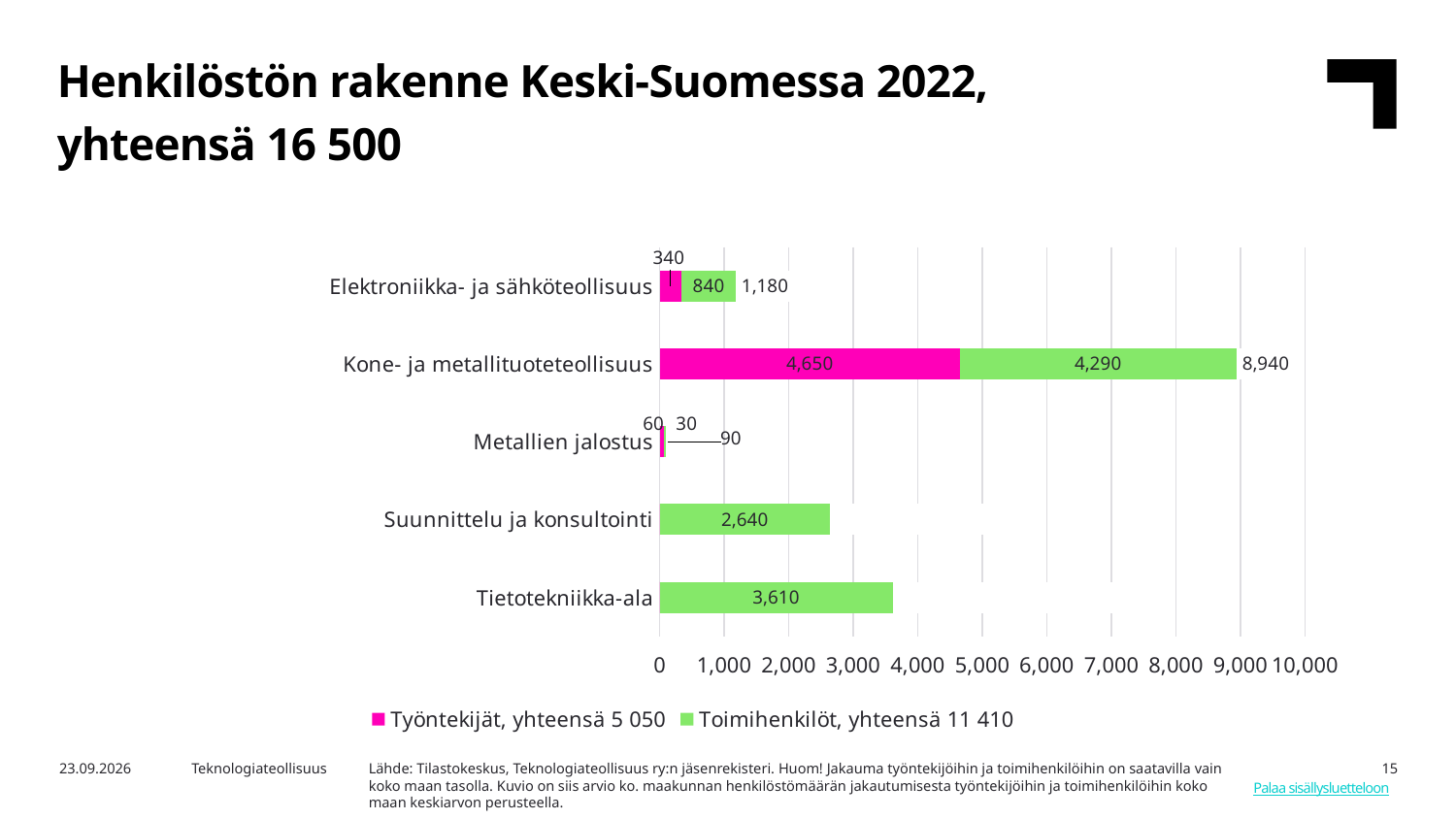
Which category has the lowest total value? Metallien jalostus What is the difference between the Toimihenkilöt values for Tietotekniikka-ala and Suunnittelu ja konsultointi? 970 What is the Työntekijät value for Kone- ja metallituoteteollisuus? 4,650 What is the total of the stacked bar for Kone- ja metallituoteteollisuus? 8,940 Which category has the highest total value? Kone- ja metallituoteteollisuus How many series does the legend list? 2 How many categories are shown on the chart? 5 What is the Toimihenkilöt value for Elektroniikka- ja sähköteollisuus? 840 What type of chart is shown on the slide? Stacked bar chart Which is larger for Kone- ja metallituoteteollisuus, the Työntekijät value or the Toimihenkilöt value? Työntekijät What is the total of the stacked bar for Metallien jalostus? 90 What is the Toimihenkilöt value for Tietotekniikka-ala? 3,610